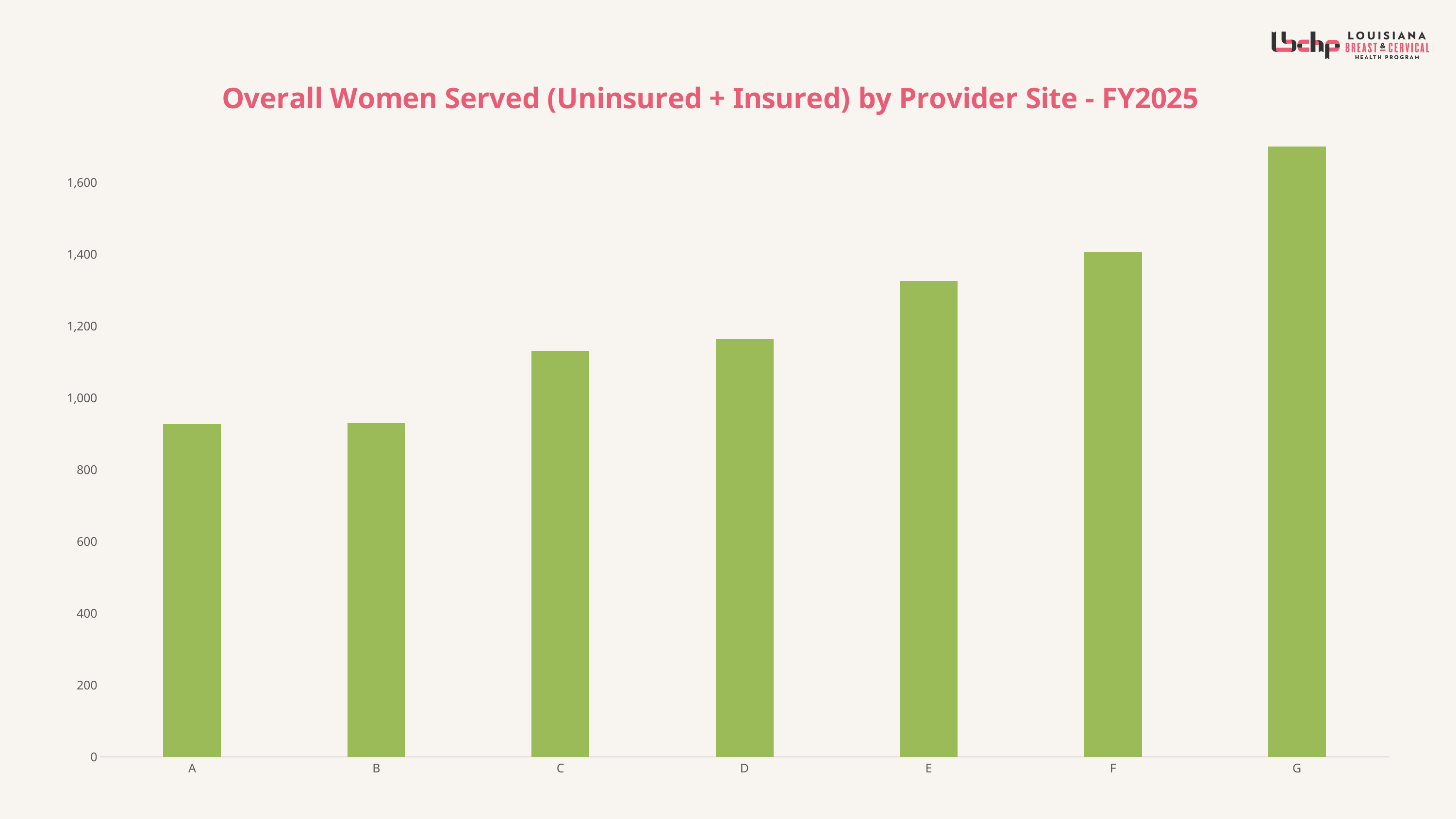
Which provider site has the larger value, B or D? D Is the value for provider site G greater or less than 1,600? greater Which provider site has the highest number of women served? G What kind of chart is shown on the slide? bar chart Do the values generally rise or fall from provider site A to provider site G? rise How many provider sites are shown on the x axis? 7 Is the value for provider site C greater or less than 1,200? less Is the value for provider site A greater or less than 1,000? less What is the title of the chart? Overall Women Served (Uninsured + Insured) by Provider Site - FY2025 Which provider site has the larger value, C or E? E